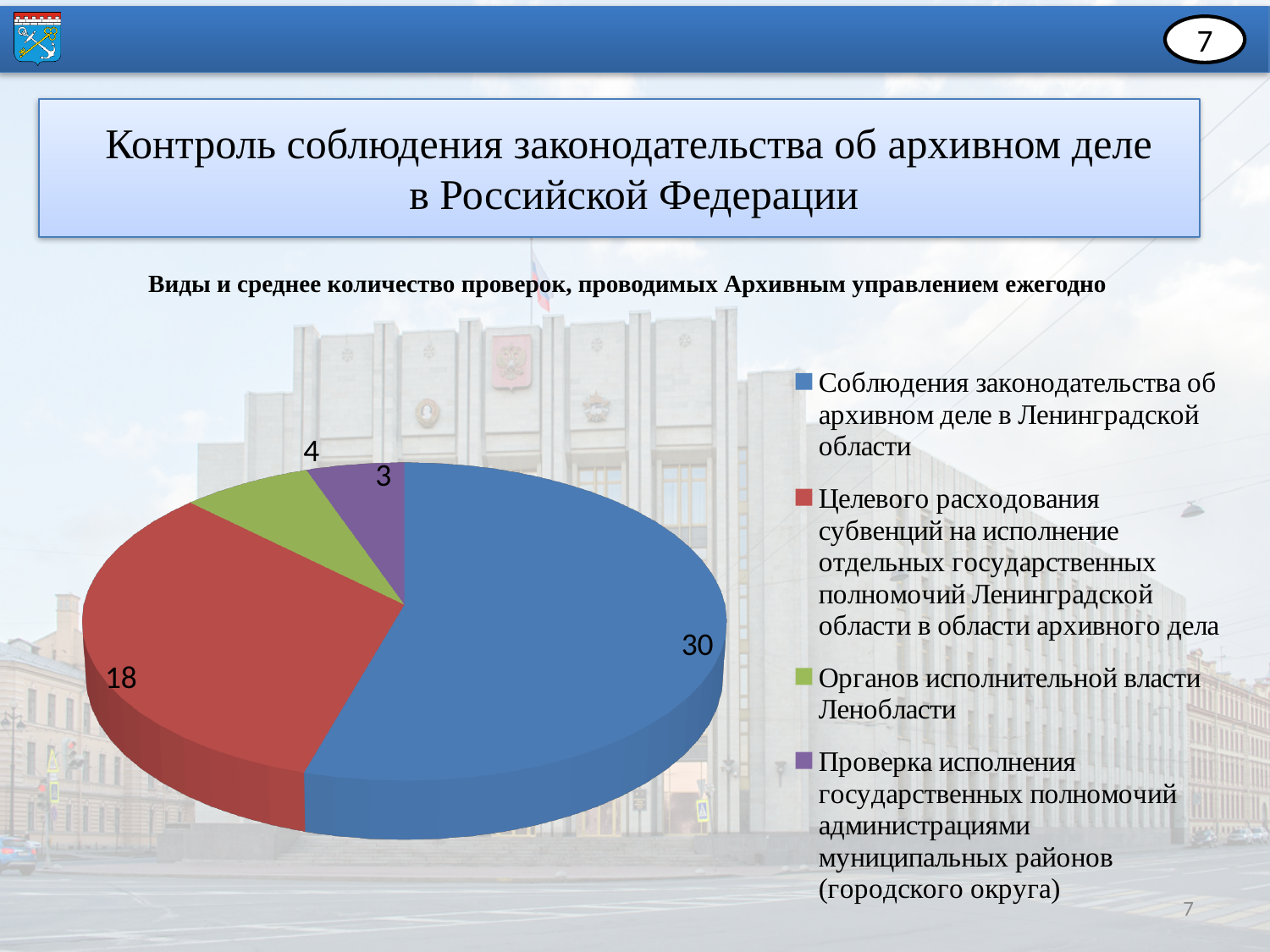
What is the value for "Целевого расходования субвенций на исполнение отдельных государственных полномочий Ленинградской области в области архивного дела"? 18 What is the total of all values shown in the pie chart? 55 What is the value for "Проверка исполнения государственных полномочий администрациями муниципальных районов (городского округа)"? 3 What colour is the slice for "Органов исполнительной власти Ленобласти"? Green What is the value for "Соблюдения законодательства об архивном деле в Ленинградской области"? 30 Which category has the largest slice of the pie chart? Соблюдения законодательства об архивном деле в Ленинградской области What is the value for "Органов исполнительной власти Ленобласти"? 4 Which category has the smallest slice of the pie chart? Проверка исполнения государственных полномочий администрациями муниципальных районов (городского округа) What is the difference between the value for "Соблюдения законодательства об архивном деле в Ленинградской области" and the value for "Целевого расходования субвенций..."? 12 How many entries does the legend of the pie chart list? 4 What kind of chart is shown on the slide? Pie chart How many slices does the pie chart have? 4